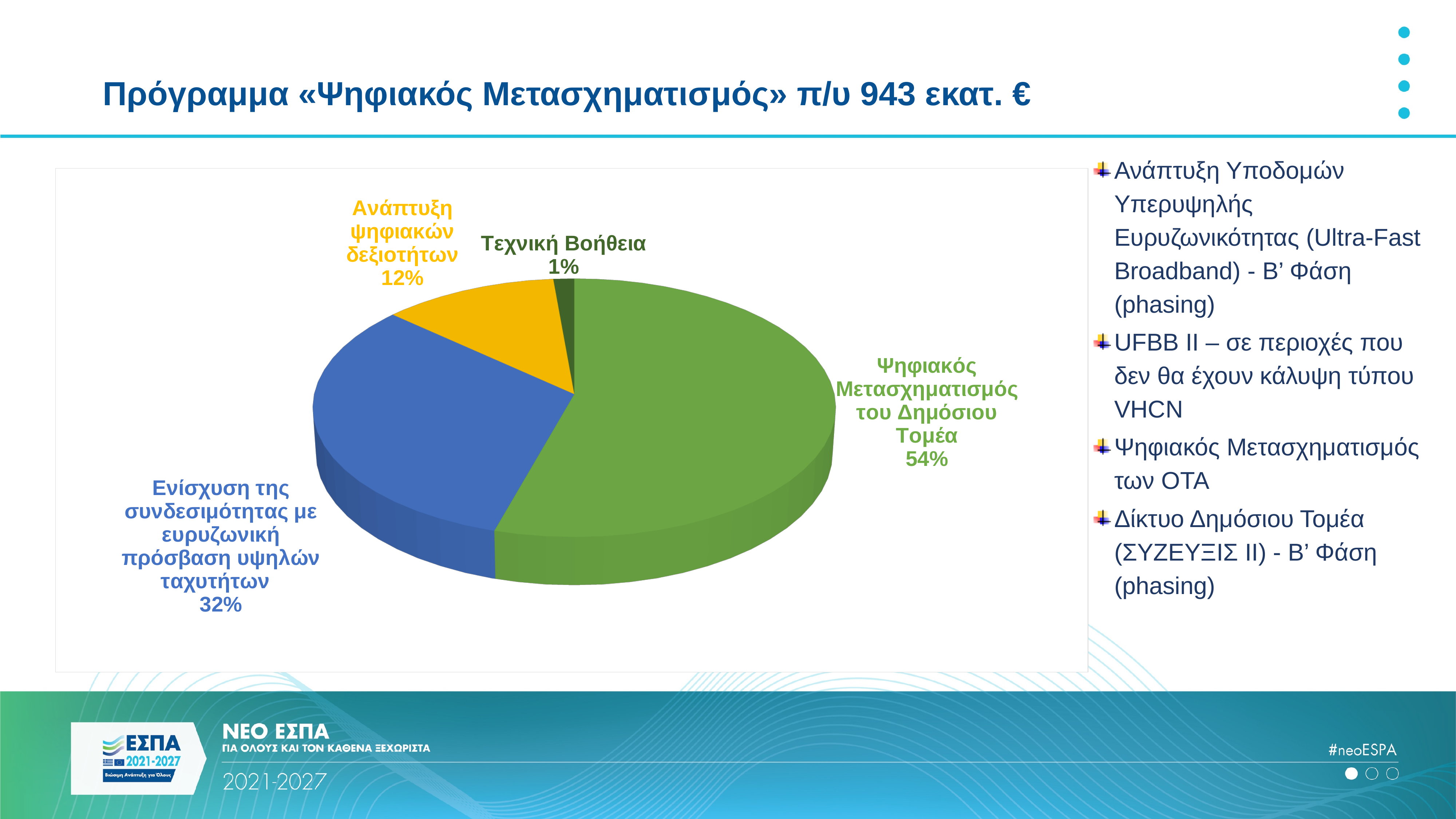
What colour is the slice for Ενίσχυση της συνδεσιμότητας με ευρυζωνική πρόσβαση υψηλών ταχυτήτων? Blue What share of the pie does Ενίσχυση της συνδεσιμότητας με ευρυζωνική πρόσβαση υψηλών ταχυτήτων represent? 32% What is the value shown for Ανάπτυξη ψηφιακών δεξιοτήτων? 12% Which is larger: the slice for Ανάπτυξη ψηφιακών δεξιοτήτων or the slice for Τεχνική Βοήθεια? Ανάπτυξη ψηφιακών δεξιοτήτων Which category has the smallest slice of the pie? Τεχνική Βοήθεια What is the difference in percentage points between Ψηφιακός Μετασχηματισμός του Δημόσιου Τομέα and Ενίσχυση της συνδεσιμότητας με ευρυζωνική πρόσβαση υψηλών ταχυτήτων? 22 percentage points What share of the pie does Ψηφιακός Μετασχηματισμός του Δημόσιου Τομέα represent? 54% What is the value shown for Τεχνική Βοήθεια? 1% What total budget is stated in the slide title for the programme «Ψηφιακός Μετασχηματισμός»? 943 εκατ. € What kind of chart is shown on the slide? Pie chart Which category has the largest slice of the pie? Ψηφιακός Μετασχηματισμός του Δημόσιου Τομέα How many slices does the pie chart have? 4